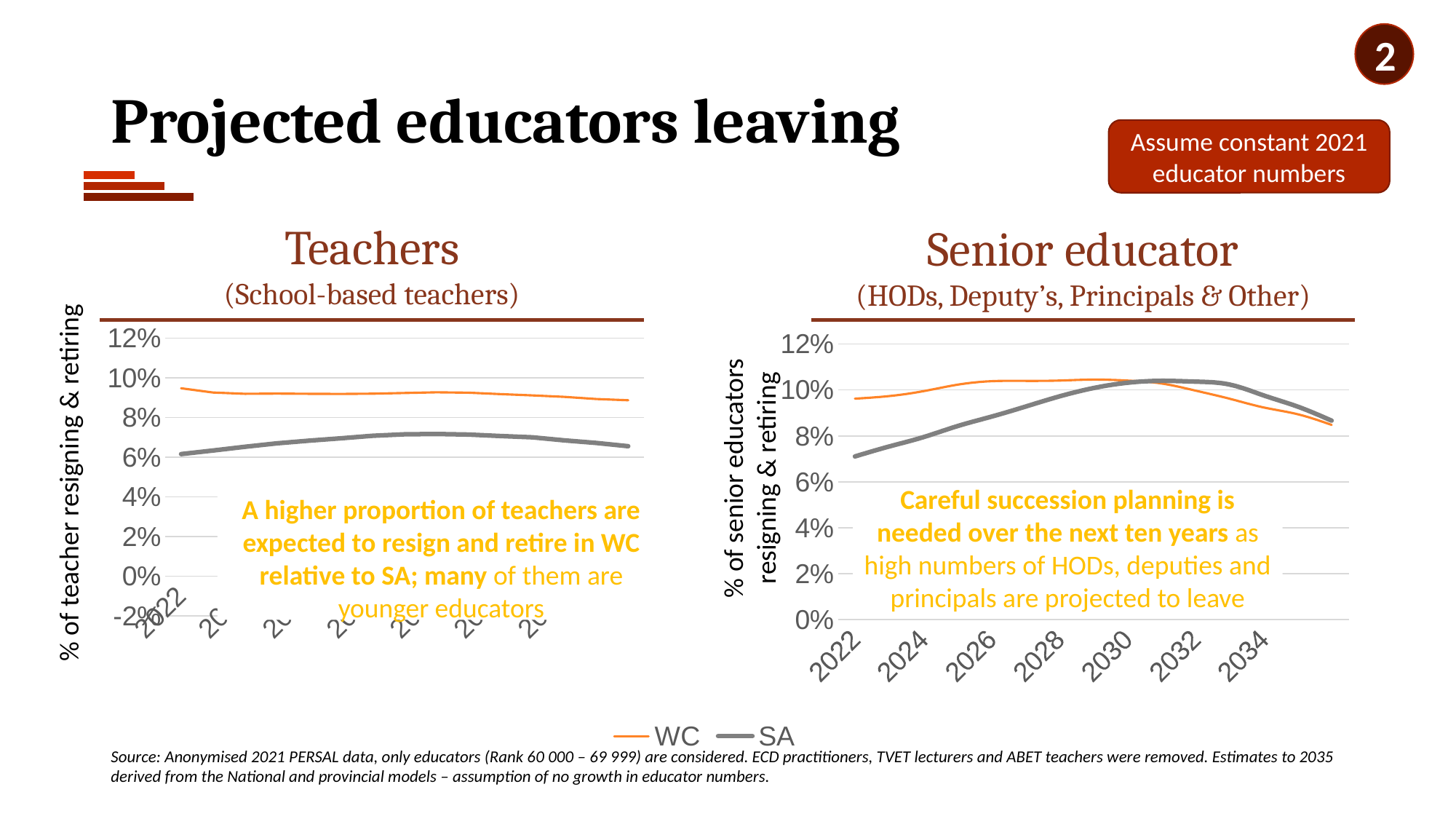
What is the subtitle of the Senior educator chart? (HODs, Deputy's, Principals & Other) In the Teachers chart, which series is higher in 2022, WC or SA? WC In the Senior educator chart, which series is higher in 2024, WC or SA? WC In the Teachers chart, is the value for WC in 2022 greater or less than 8%? greater What kind of chart is the Teachers chart? line chart How many series does the legend list? 2 In the Senior educator chart, does the SA line rise or fall between 2022 and 2030? rise What kind of chart is the Senior educator chart? line chart In the Teachers chart, is the value for SA in 2022 greater or less than 8%? less In the Senior educator chart, is the value for WC in 2022 greater or less than 8%? greater Which colour represents SA in the legend? grey